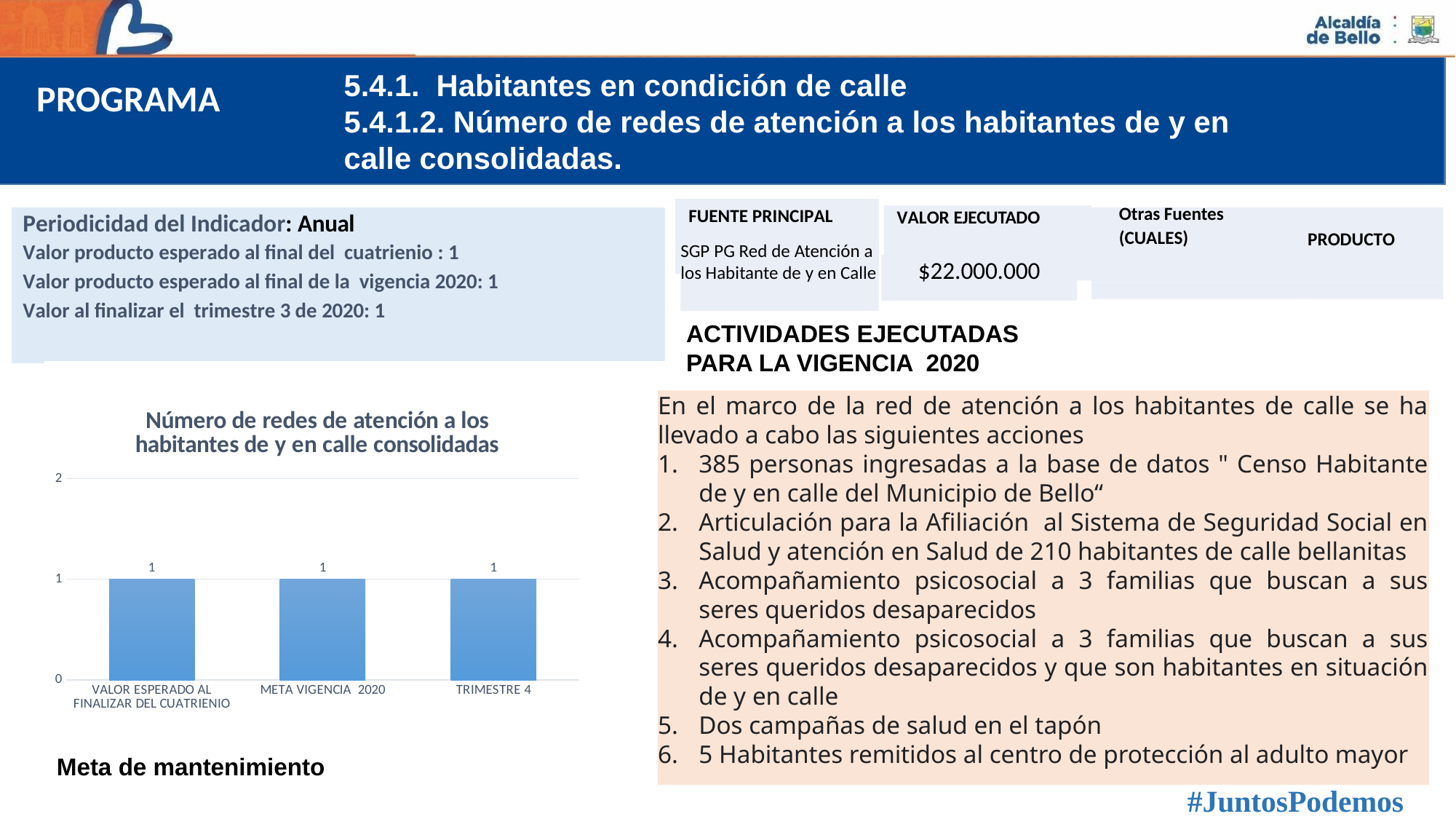
What is the value for META VIGENCIA 2020? 1 What is the highest value shown on the chart's y axis? 2 What is the title of the chart? Número de redes de atención a los habitantes de y en calle consolidadas What is the value for VALOR ESPERADO AL FINALIZAR DEL CUATRIENIO? 1 What kind of chart is shown on the slide? bar chart Do the values rise, fall or stay the same across the categories from left to right? stay the same How many categories are shown on the x axis of the chart? 3 Is the value for TRIMESTRE 4 greater or less than 2? less What is the value for TRIMESTRE 4? 1 What is the difference between the value for TRIMESTRE 4 and the value for META VIGENCIA 2020? 0